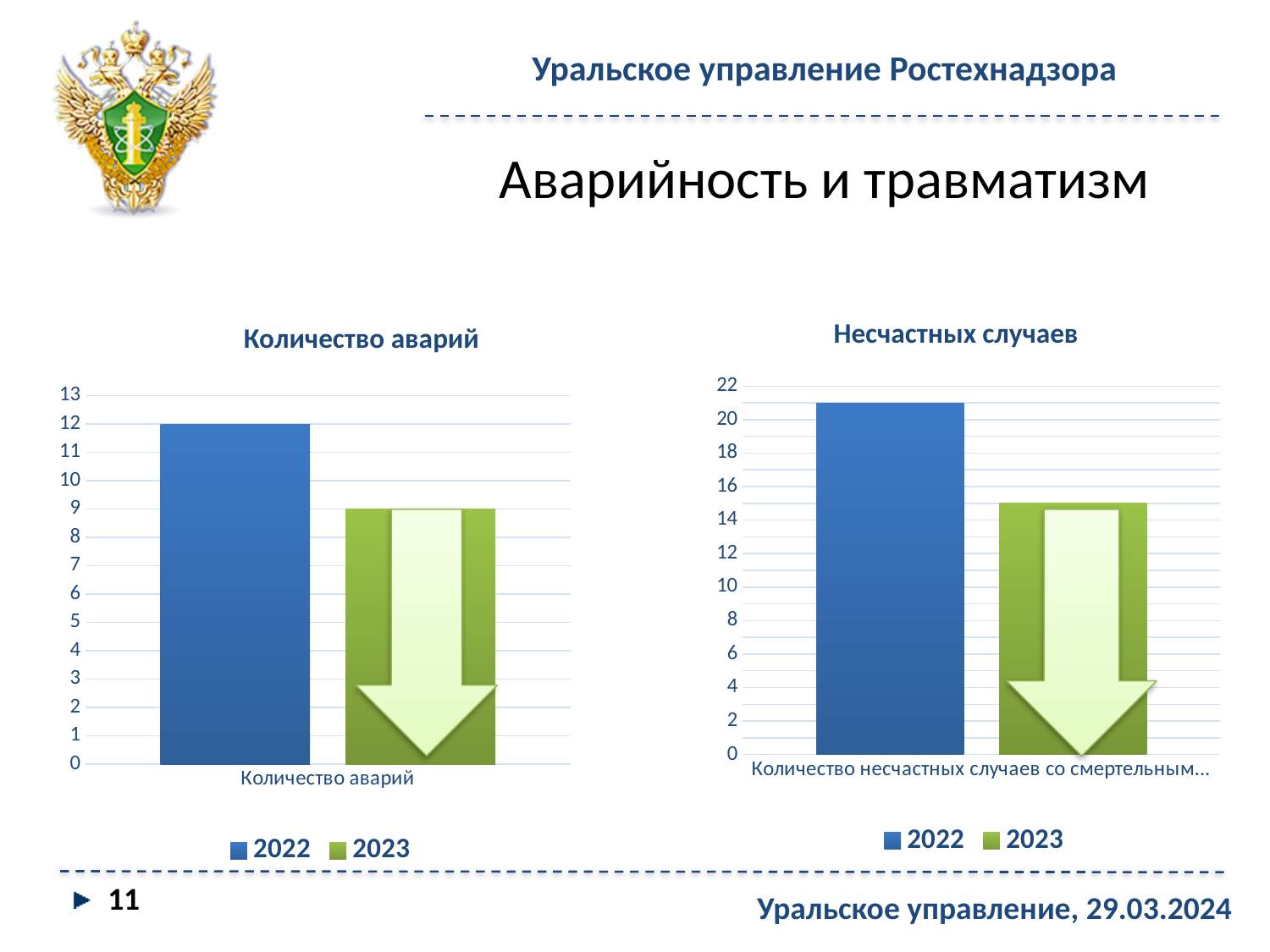
In the chart titled "Несчастных случаев", what kind of chart is shown? bar chart In the chart titled "Количество аварий", what is the difference between the 2022 and 2023 values? 3 In the chart titled "Количество аварий", which series has the higher value, 2022 or 2023? 2022 In the chart titled "Количество аварий", how many series does the legend list? 2 In the chart titled "Несчастных случаев", do the values rise or fall from 2022 to 2023? fall In the chart titled "Количество аварий", what colour is the bar for 2023? green In the chart titled "Несчастных случаев", is the value for 2023 greater or less than 16? less In the chart titled "Количество аварий", what is the value for 2022? 12 In the chart titled "Несчастных случаев", is the value for 2022 greater or less than 20? greater In the chart titled "Несчастных случаев", what is the highest value shown on the vertical axis? 22 In the chart titled "Несчастных случаев", which series has the lower value, 2022 or 2023? 2023 In the chart titled "Количество аварий", what is the value for 2023? 9